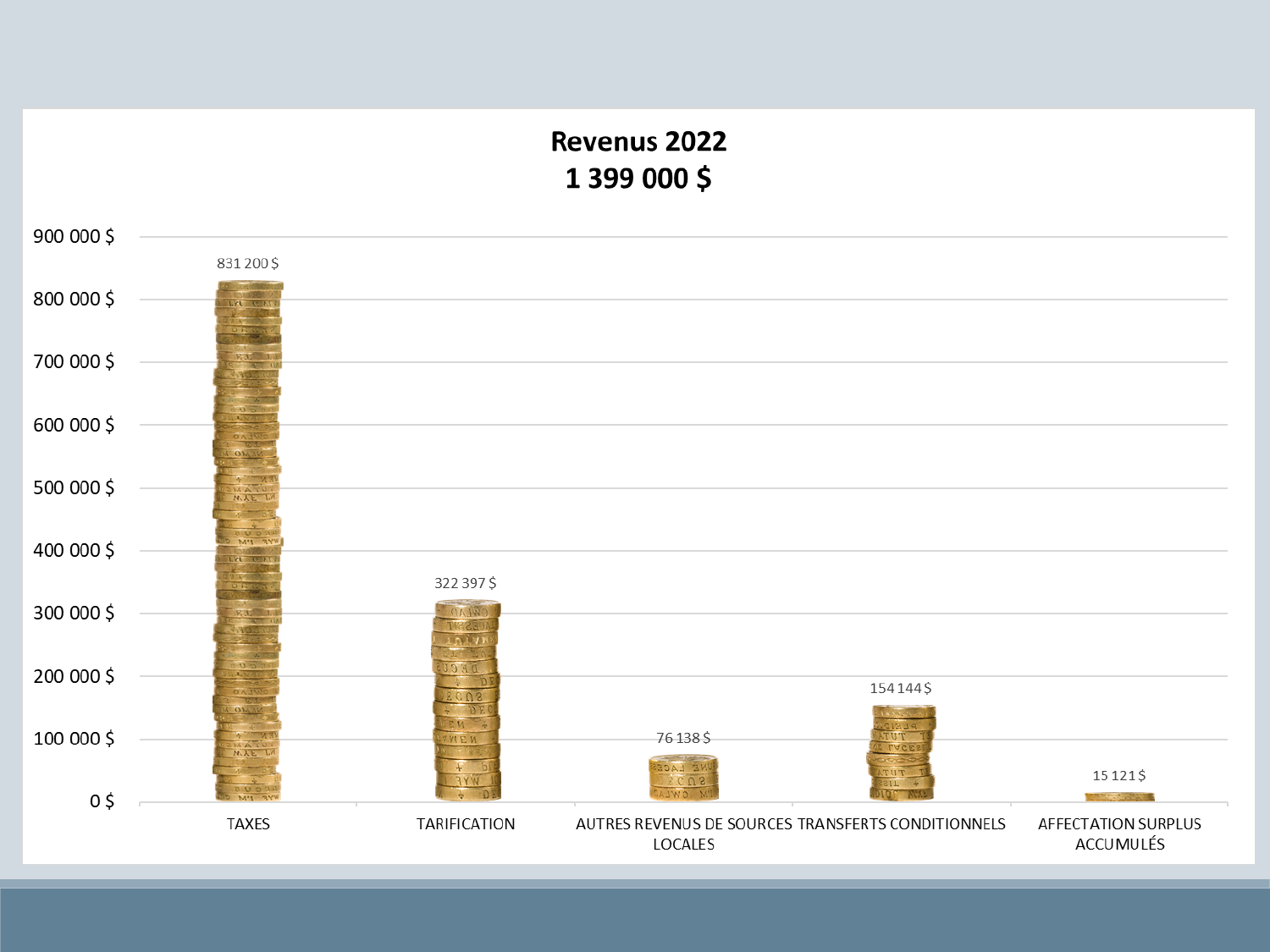
What is the value for AFFECTATION SURPLUS ACCUMULÉS? 15 121 $ Which category has the lowest value? AFFECTATION SURPLUS ACCUMULÉS What is the difference between the values for TAXES and TARIFICATION? 508 803 $ What is the value for TAXES? 831 200 $ What is the value for TARIFICATION? 322 397 $ Which is larger, TRANSFERTS CONDITIONNELS or AUTRES REVENUS DE SOURCES LOCALES? TRANSFERTS CONDITIONNELS What is the value for TRANSFERTS CONDITIONNELS? 154 144 $ What is the value for AUTRES REVENUS DE SOURCES LOCALES? 76 138 $ Which category has the highest value? TAXES What is the title of the chart? Revenus 2022 1 399 000 $ How many categories are shown on the x axis? 5 What kind of chart is this? bar chart